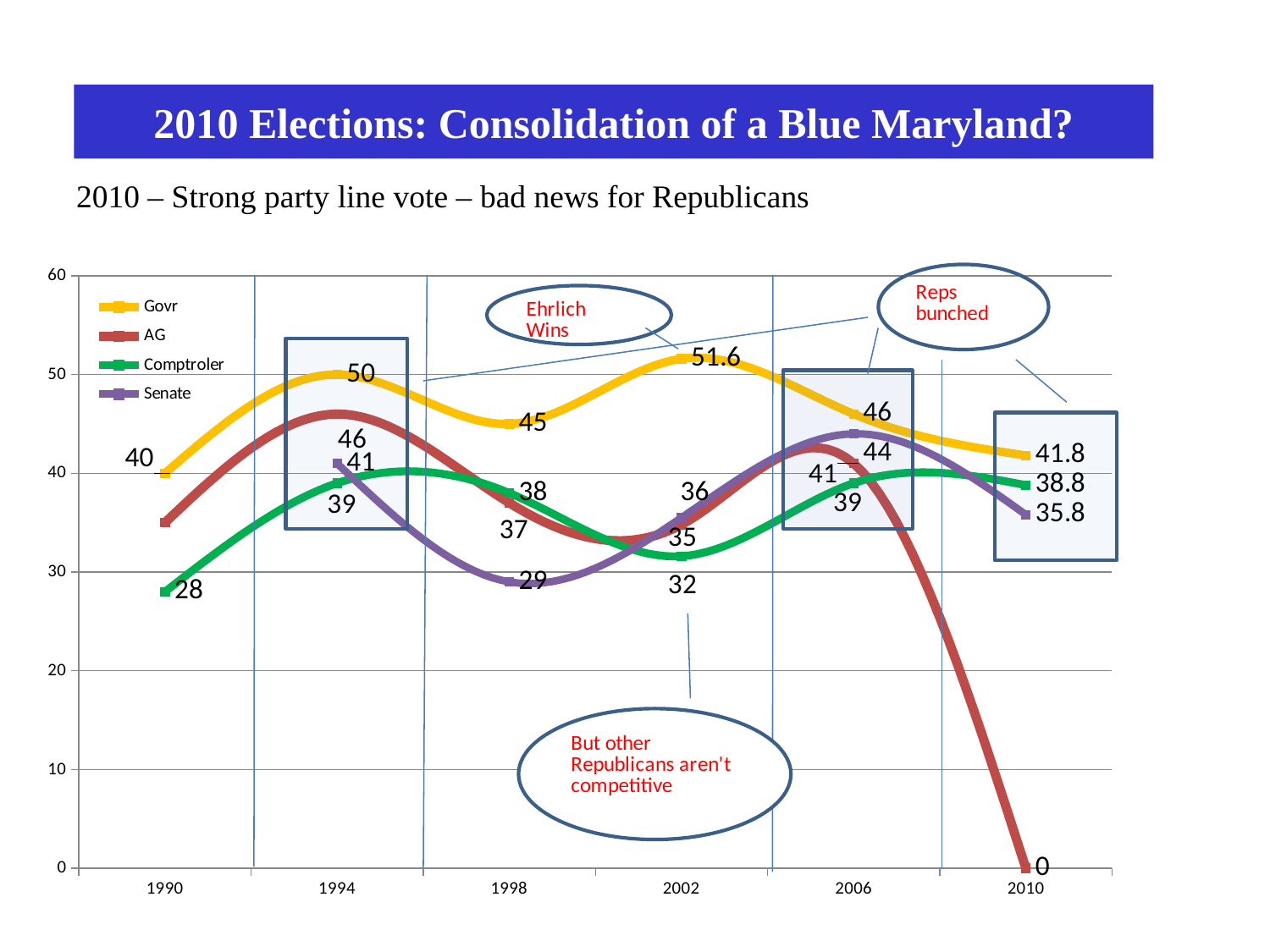
What kind of chart is shown on the slide? line chart How many series does the legend list? 4 In which year is the AG series lowest? 2010 How many election years are shown on the x axis? 6 What is the AG value for 2010? 0 What is the Comptroler value for 1990? 28 What is the Govr value for 2002? 51.6 What is the difference between the Govr value and the Senate value in 2010? 6 Which is larger, the Govr value in 1994 or in 1998? 1994 What is the Govr value for 2010? 41.8 What is the Senate value for 2010? 35.8 In which year is the Govr series highest? 2002